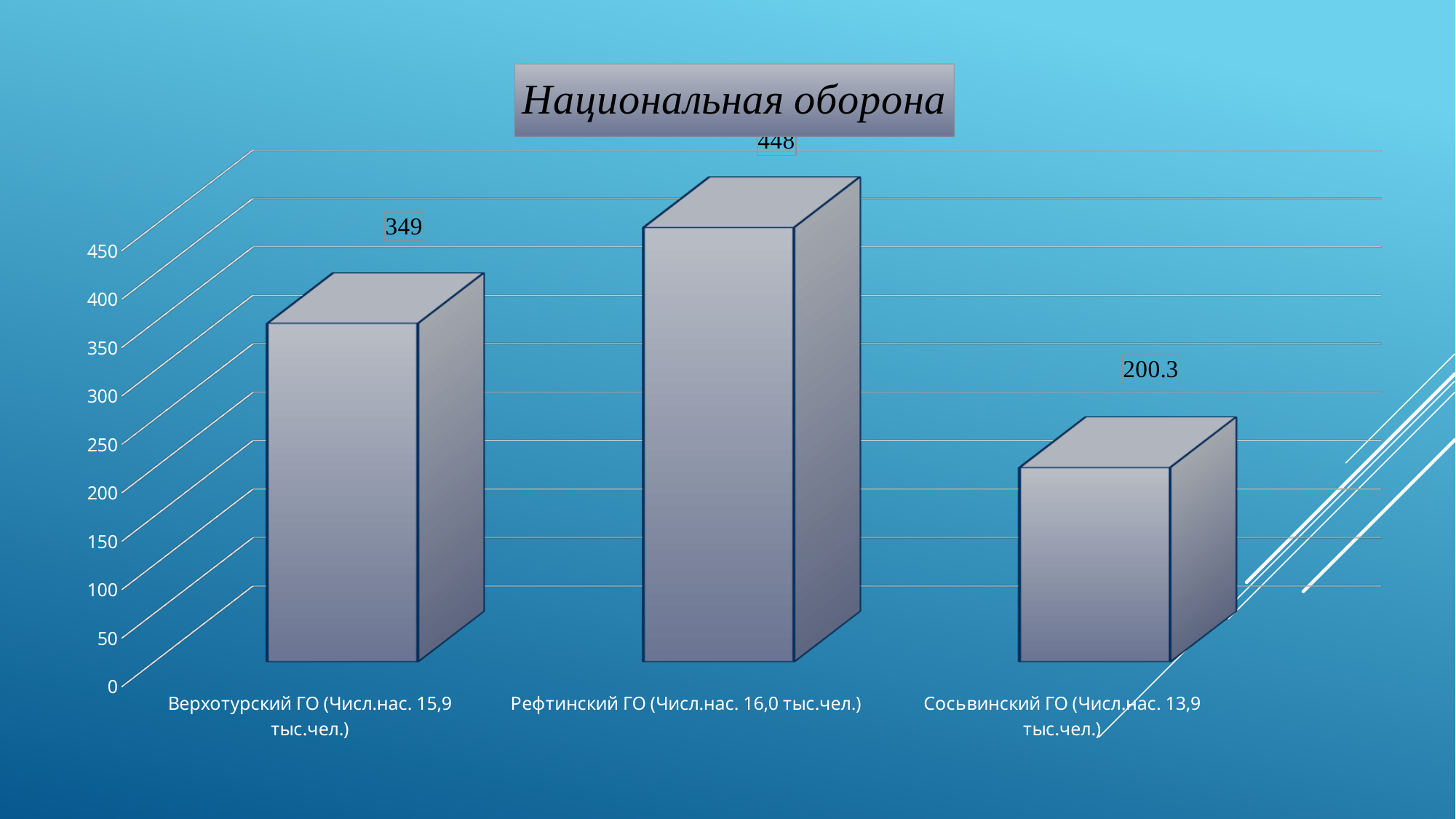
What is the difference between the values for Рефтинский ГО and Верхотурский ГО? 99 Which is larger, the value for Верхотурский ГО or the value for Сосьвинский ГО? Верхотурский ГО Which category has the lowest value? Сосьвинский ГО Which category has the highest value? Рефтинский ГО What is the difference between the values for Верхотурский ГО and Сосьвинский ГО? 148.7 What is the value for Сосьвинский ГО? 200.3 How many categories are shown on the chart? 3 What is the title of the chart? Национальная оборона What is the value for Верхотурский ГО? 349 What is the highest tick value shown on the vertical axis? 450 What is the value for Рефтинский ГО? 448 What kind of chart is shown on the slide? bar chart